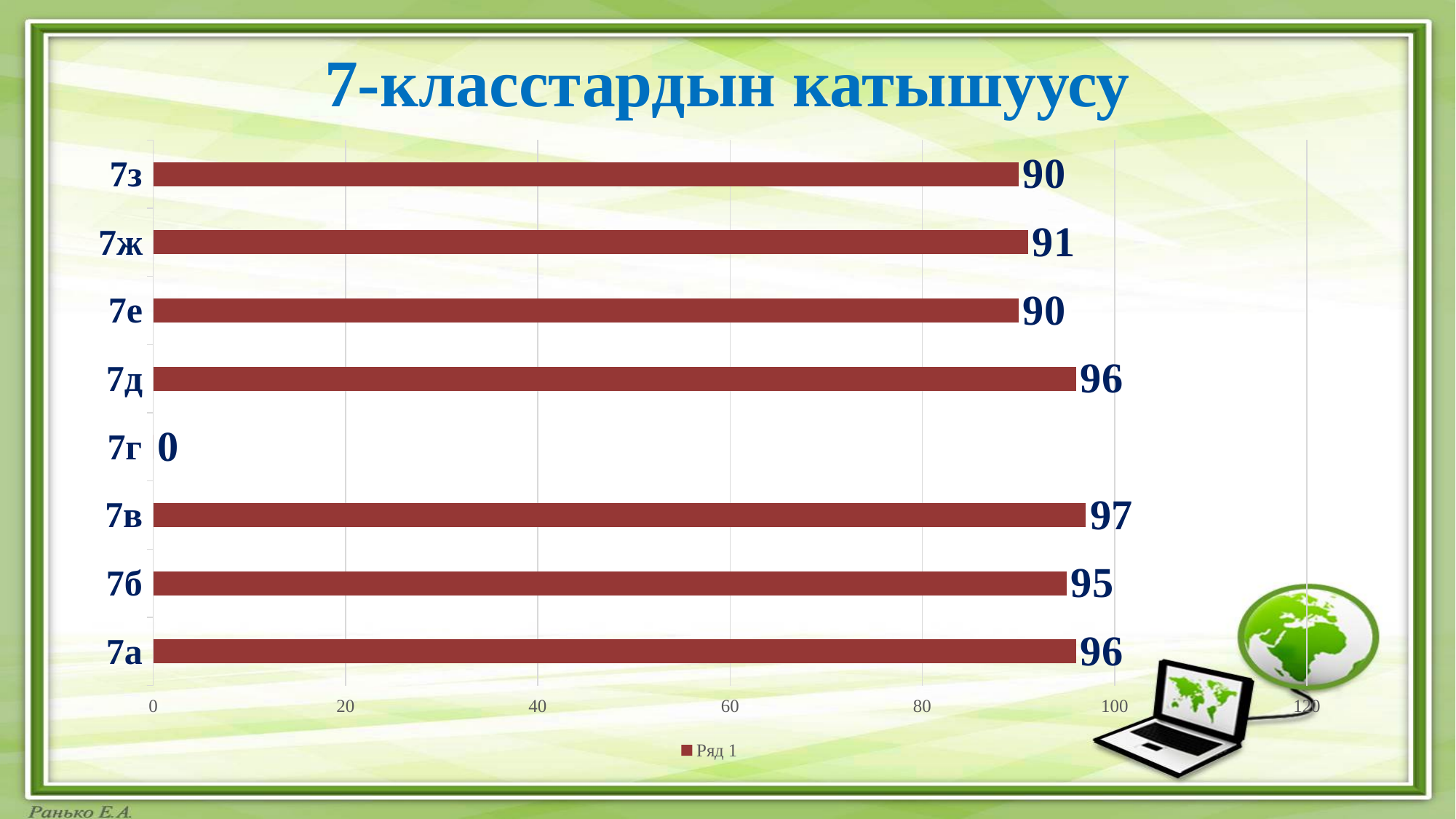
What is the difference between the values for 7в and 7з? 7 Which category has the highest value? 7в How many series does the legend list? 1 Which category has the lowest value? 7г How many categories are shown on the chart? 8 Is the value for 7а greater or less than 80? greater What is the value for 7ж? 91 What is the value for 7д? 96 What is the value for 7г? 0 Which is larger, the value for 7б or the value for 7е? 7б What is the title of the chart? 7-класстардын катышуусу What kind of chart is shown on the slide? bar chart